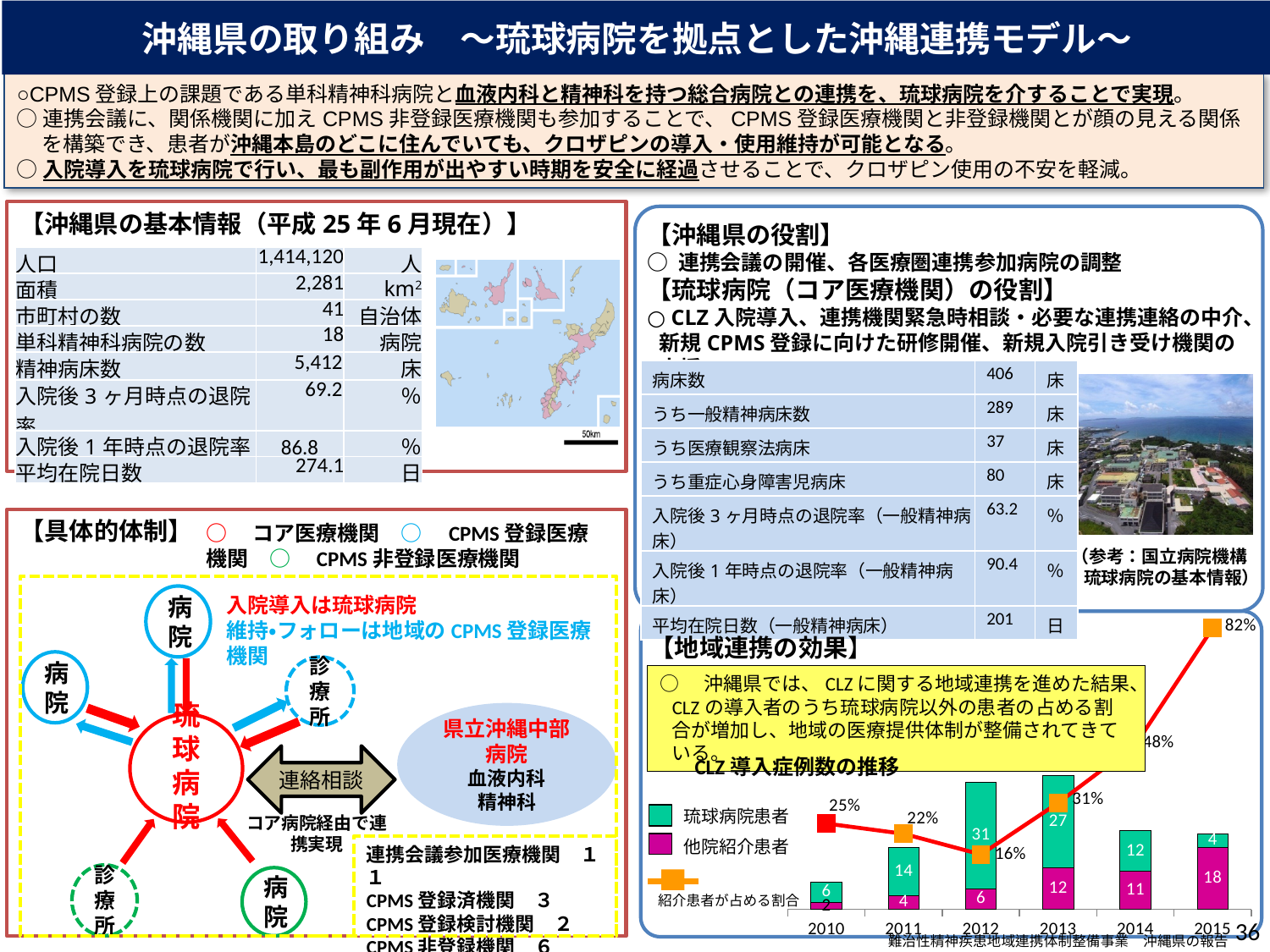
In the chart titled CLZ導入症例数の推移, what is the difference between the 琉球病院患者 values for 2012 and 2013? 4 In the chart titled CLZ導入症例数の推移, what is the total of the stacked bar for 2013? 39 In the chart titled CLZ導入症例数の推移, how many years are shown on the x axis? 6 In the chart titled CLZ導入症例数の推移, how many entries does the legend list? 3 In the chart titled CLZ導入症例数の推移, which is larger in 2014: 琉球病院患者 or 他院紹介患者? 琉球病院患者 In the chart titled CLZ導入症例数の推移, what is the value for 他院紹介患者 in 2015? 18 In the chart titled CLZ導入症例数の推移, which year has the highest 紹介患者が占める割合? 2015 In the chart titled CLZ導入症例数の推移, does the 紹介患者が占める割合 line rise or fall from 2012 to 2015? rise In the chart titled CLZ導入症例数の推移, which year has the highest value for 琉球病院患者? 2012 In the chart titled CLZ導入症例数の推移, what is the 紹介患者が占める割合 shown for 2014? 48% In the chart titled CLZ導入症例数の推移, which year has the lowest 紹介患者が占める割合? 2012 In the chart titled CLZ導入症例数の推移, what is the value for 琉球病院患者 in 2012? 31